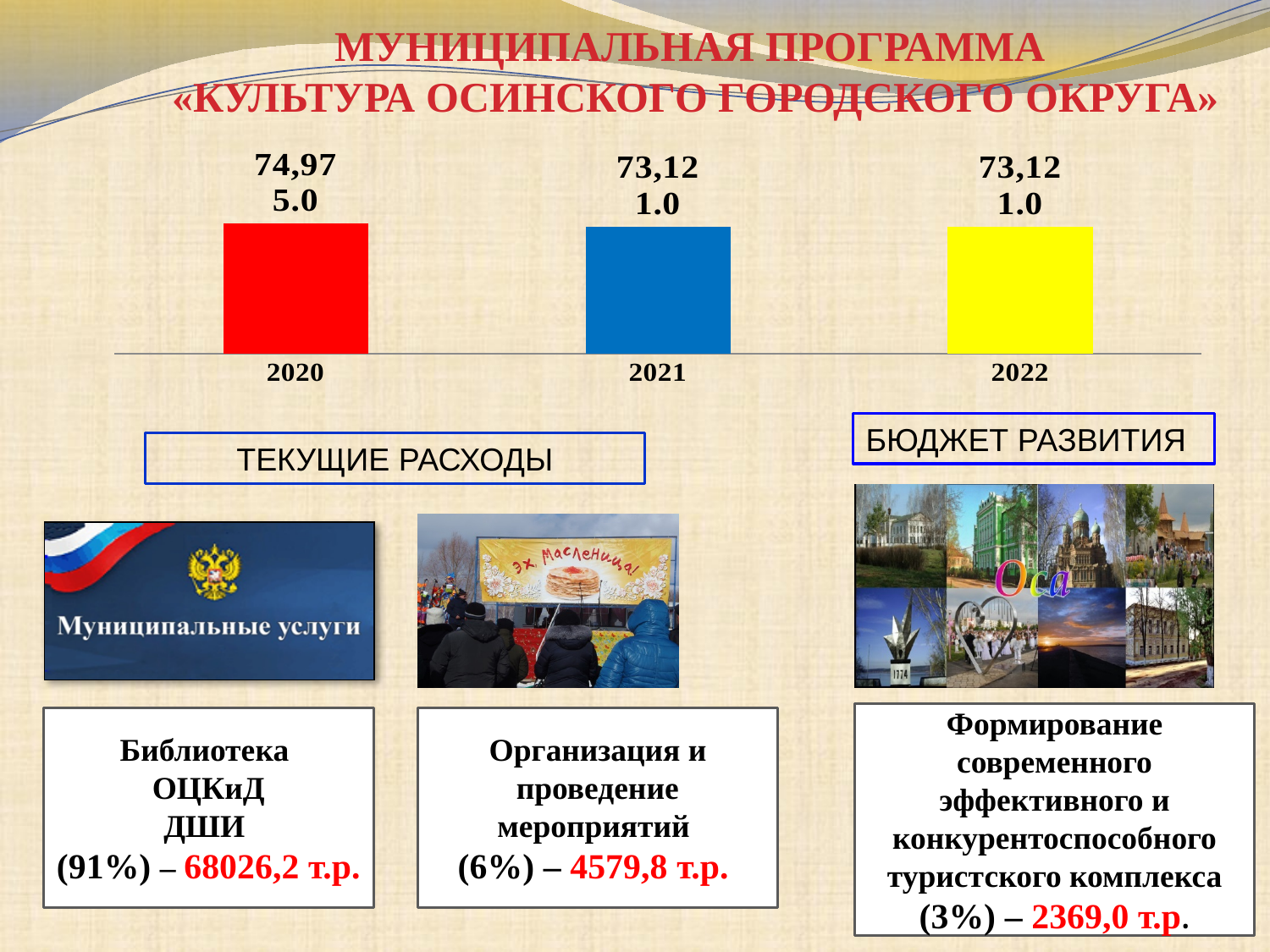
What is the data label printed above the 2021 bar? 73,121.0 Which year has the highest bar in the chart? 2020 Do the bar values rise or fall from 2020 to 2021? fall What colour is the bar for 2022? yellow What is the data label printed above the 2020 bar? 74,975.0 How many bars (years) does the chart show? 3 Which bar is taller, 2020 or 2021? 2020 Are the bars for 2021 and 2022 the same height or different? the same Which bar is taller, 2020 or 2022? 2020 What colour is the bar for 2020? red What kind of chart is shown at the top of the slide? bar chart